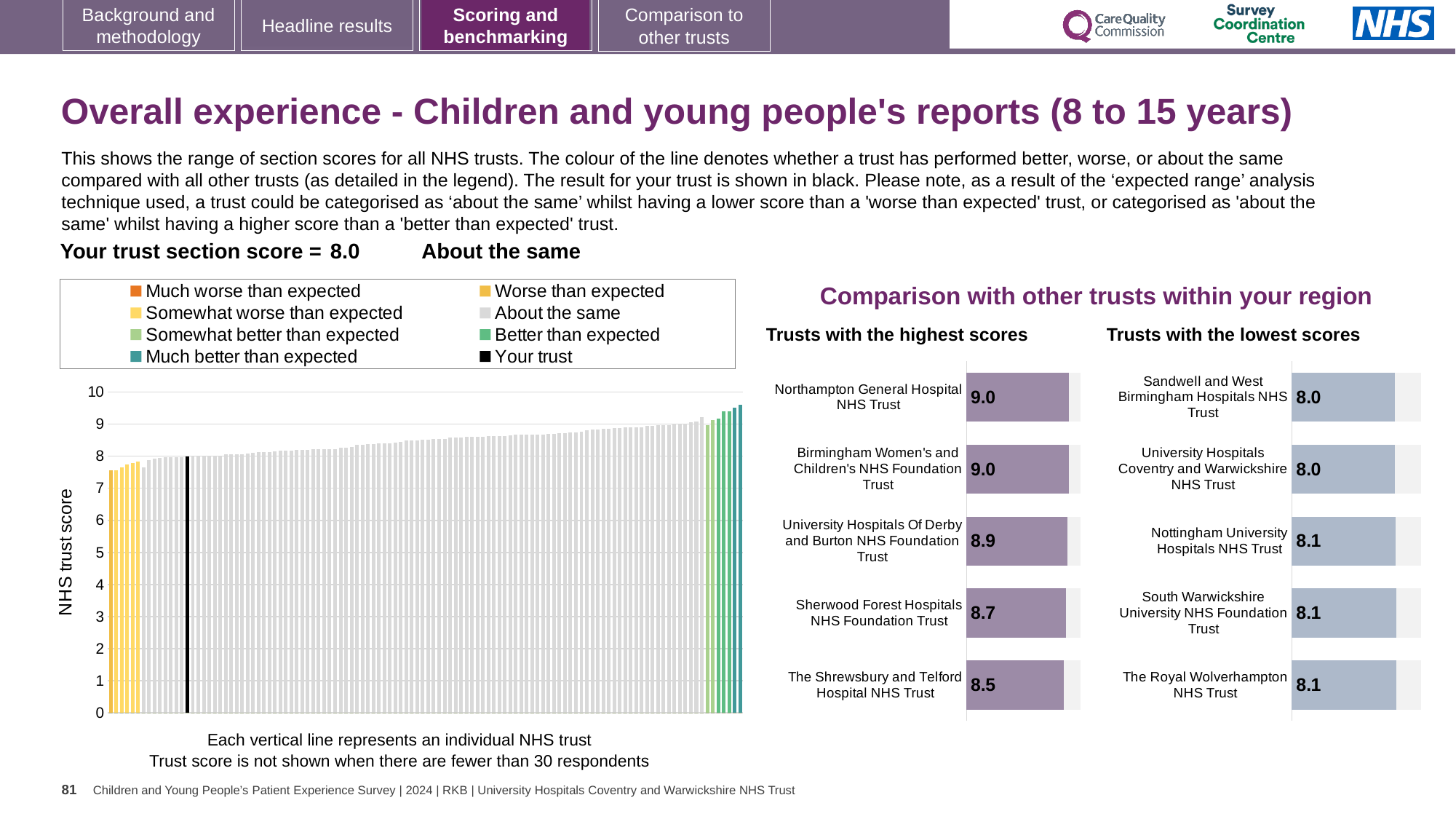
In the 'Trusts with the highest scores' chart, which has the higher score: University Hospitals Of Derby and Burton NHS Foundation Trust or Sherwood Forest Hospitals NHS Foundation Trust? University Hospitals Of Derby and Burton NHS Foundation Trust In the 'Trusts with the highest scores' chart, which trust has the lowest score shown? The Shrewsbury and Telford Hospital NHS Trust In the 'Trusts with the lowest scores' chart, what is the score for University Hospitals Coventry and Warwickshire NHS Trust? 8.0 In the main chart on the left, do the trust scores rise or fall from left to right? Rise In the 'Trusts with the lowest scores' chart, what is the score for Nottingham University Hospitals NHS Trust? 8.1 In the 'Trusts with the highest scores' chart, what is the difference between the scores of Northampton General Hospital NHS Trust and The Shrewsbury and Telford Hospital NHS Trust? 0.5 In the 'Trusts with the highest scores' chart, what is the score for Sherwood Forest Hospitals NHS Foundation Trust? 8.7 In the 'Trusts with the highest scores' chart, what is the score for Northampton General Hospital NHS Trust? 9.0 How many trusts are listed in the 'Trusts with the lowest scores' chart? 5 How many entries does the legend of the main chart on the left list? 8 What is the label on the vertical axis of the main chart on the left? NHS trust score What type of chart is the main chart on the left showing all NHS trusts? Bar chart